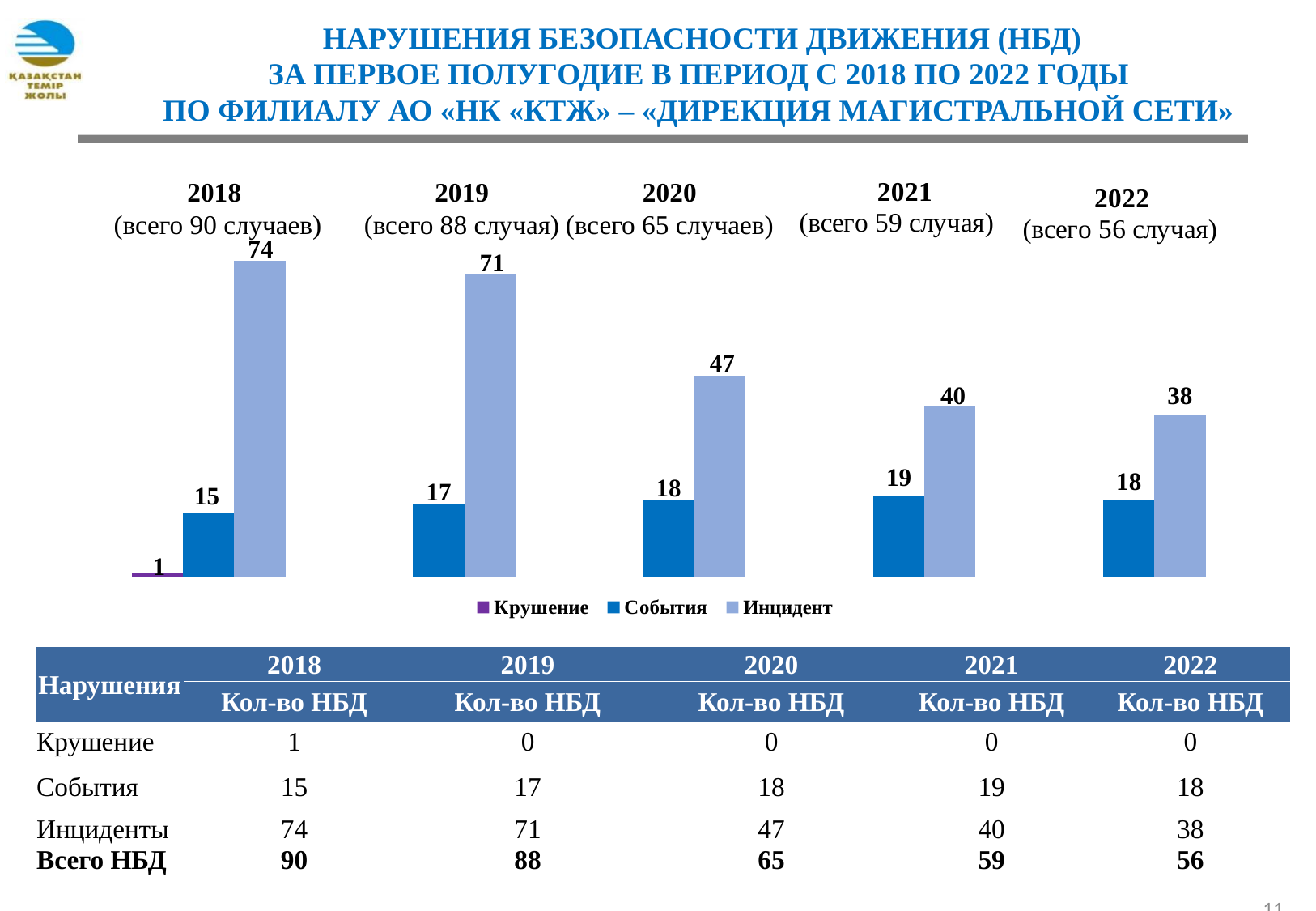
What is the value of Крушение for 2018? 1 Which is larger: События in 2021 or События in 2018? События in 2021 What kind of chart is shown on the slide? bar chart What is the value of События for 2021? 19 Which year has the lowest value for Инцидент? 2022 How many series does the legend list? 3 Does the Инцидент series rise or fall from 2018 to 2022? fall What is the difference between the Инцидент values for 2019 and 2020? 24 Which series is shown in purple in the legend? Крушение What is the value of Инцидент for 2018? 74 Which year has the highest value for Инцидент? 2018 How many years are shown on the x axis of the chart? 5